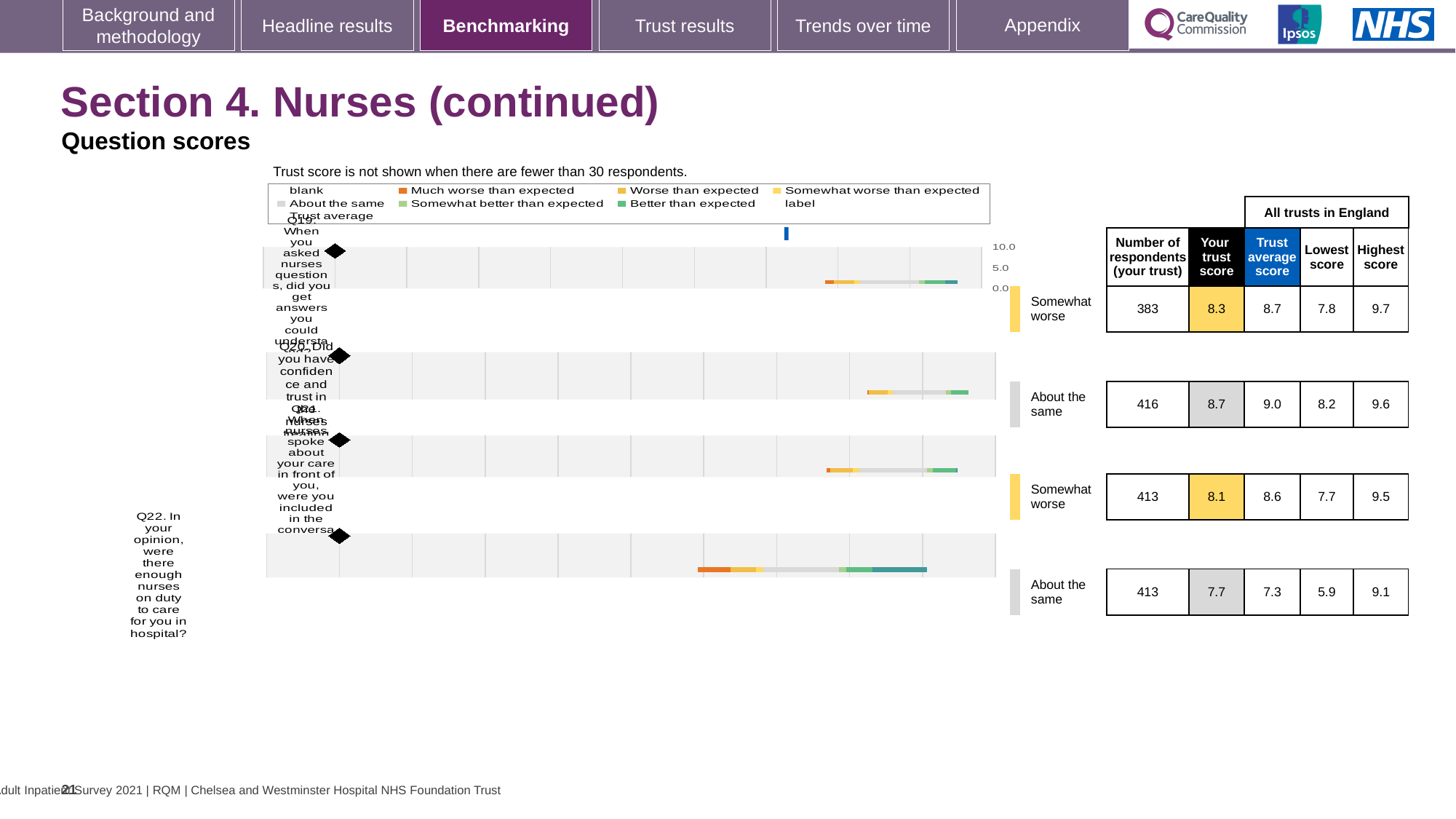
Which question has the lowest 'Your trust score'? Q22 What benchmark category is shown for Q21 (were you included in the conversation)? Somewhat worse What is the lowest score across all trusts in England for Q22? 5.9 What is the trust average score for Q22 (were there enough nurses on duty)? 7.3 For Q21, which is larger: the 'Your trust score' or the trust average score? Trust average score According to the note above the chart, the trust score is not shown when there are fewer than how many respondents? 30 What is the 'Your trust score' for Q19 (when you asked nurses questions, did you get answers you could understand)? 8.3 What kind of chart is shown on the slide? Bar chart What is the difference between the 'Your trust score' and the trust average score for Q22? 0.4 Which question has the highest 'Your trust score'? Q20 How many respondents from your trust answered Q20 (did you have confidence and trust in the nurses)? 416 How many questions are plotted on the chart? 4